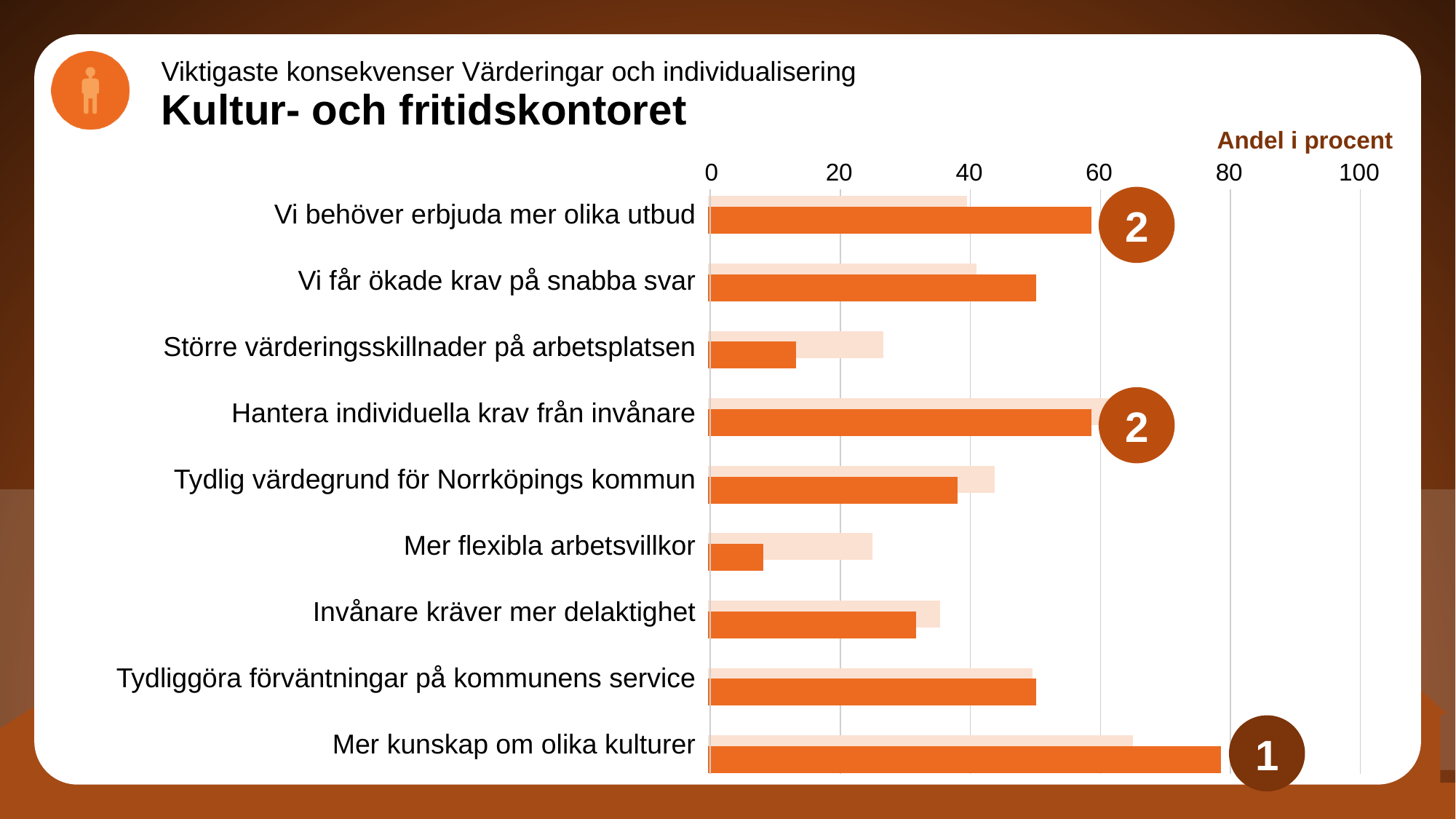
Is the dark orange bar for 'Vi behöver erbjuda mer olika utbud' greater or less than 40? greater How many categories are listed on the chart? 9 Which category has the longest dark orange bar? Mer kunskap om olika kulturer Is the dark orange bar for 'Mer flexibla arbetsvillkor' greater or less than 20? less Is the dark orange bar for 'Mer kunskap om olika kulturer' greater or less than 60? greater Which has the longer dark orange bar: 'Vi behöver erbjuda mer olika utbud' or 'Tydlig värdegrund för Norrköpings kommun'? Vi behöver erbjuda mer olika utbud Which has the longer dark orange bar: 'Invånare kräver mer delaktighet' or 'Tydliggöra förväntningar på kommunens service'? Tydliggöra förväntningar på kommunens service What label is shown above the horizontal axis of the chart? Andel i procent Which category has the shortest dark orange bar? Mer flexibla arbetsvillkor What kind of chart is shown on the slide? bar chart